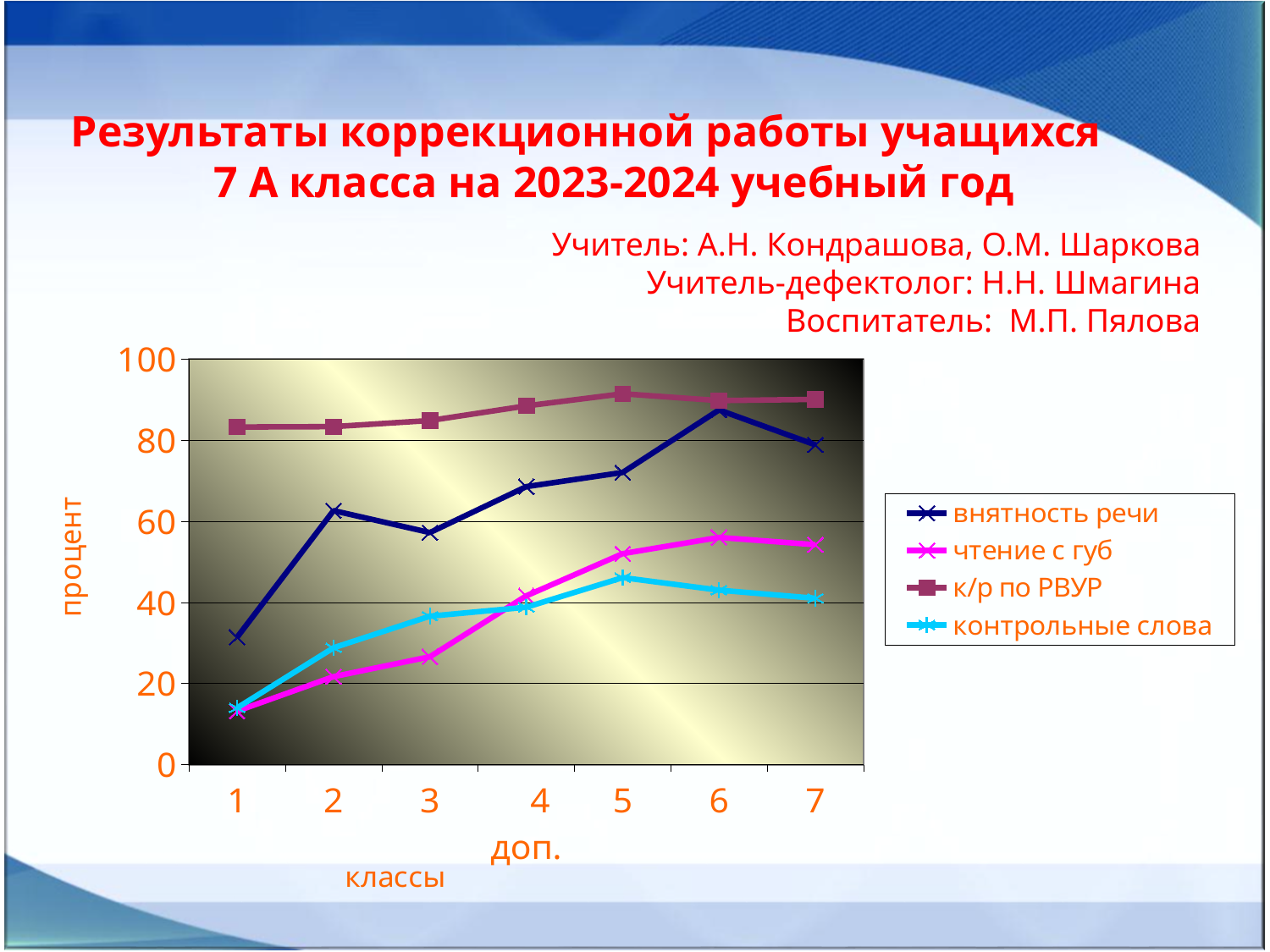
Which series has the lowest value at category 7? контрольные слова Is the value for 'внятность речи' at category 1 greater or less than 40? less Which series has the highest value at category 1? к/р по РВУР Does the series 'к/р по РВУР' rise or fall from category 1 to category 5? rise How many categories are shown along the x axis? 7 Is the value for 'к/р по РВУР' at category 5 greater or less than 80? greater What is the title of the vertical axis? процент At which category does the series 'внятность речи' reach its highest value? 6 What kind of chart is shown on the slide? line chart How many series does the legend list? 4 At category 2, which is larger: 'внятность речи' or 'чтение с губ'? внятность речи Is the value for 'чтение с губ' at category 3 greater or less than 40? less